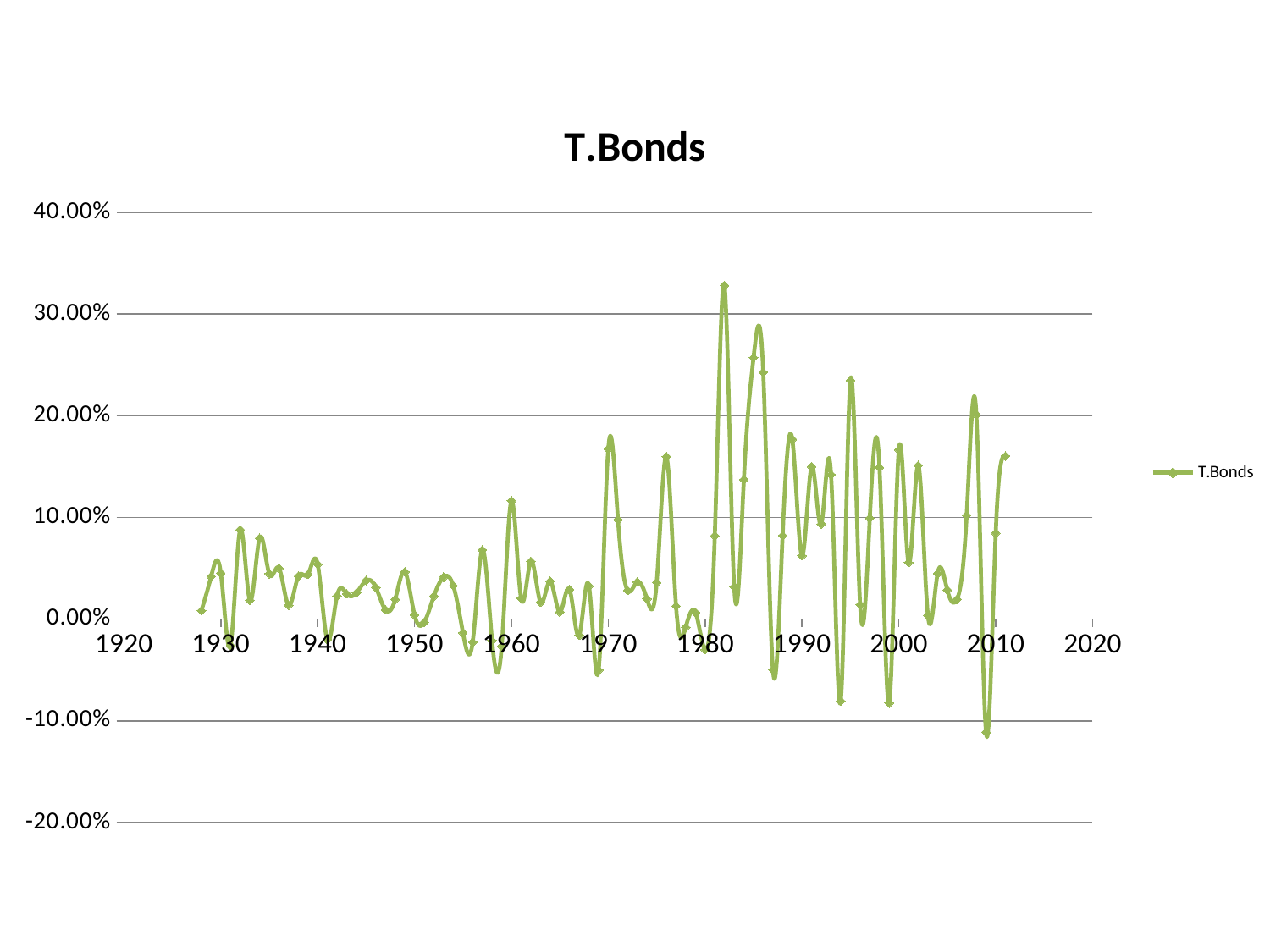
What kind of chart is shown on the slide? line chart Is the value of T.Bonds around 1995 greater or less than 20.00%? greater What is the title of the chart? T.Bonds Is the value of T.Bonds around 1970 greater or less than 10.00%? greater Is the value of T.Bonds around 2009 greater or less than 0.00%? less How many series does the legend list? 1 Which is larger, the T.Bonds value around 1982 or the value around 1985? 1982 What is the name of the series shown in the legend? T.Bonds Which is larger, the T.Bonds value around 1995 or the value around 1930? 1995 Around which year does the T.Bonds series reach its lowest value? 2009 Around which year does the T.Bonds series reach its highest value? 1982